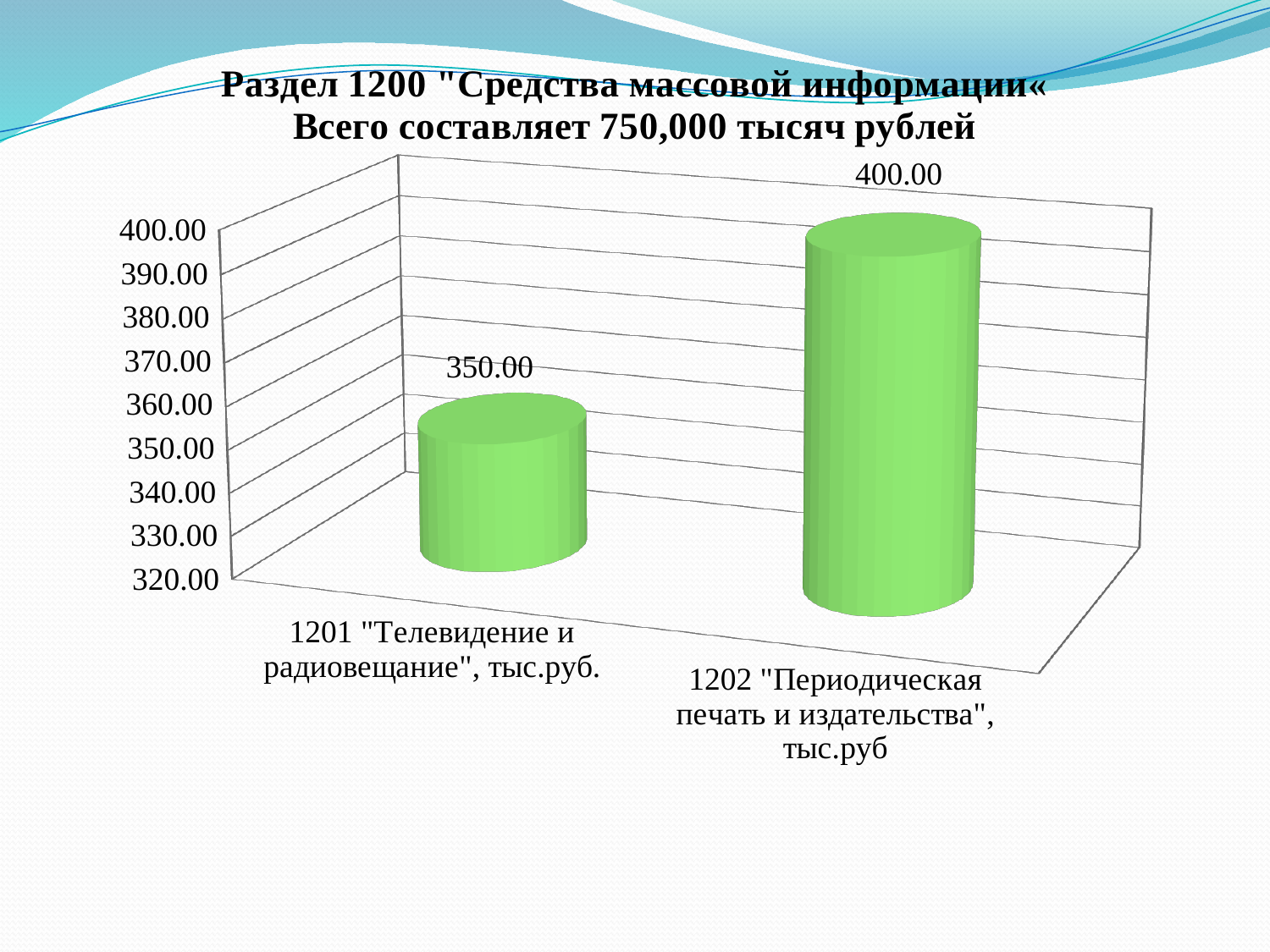
Which is larger: the value for 1201 "Телевидение и радиовещание" or for 1202 "Периодическая печать и издательства"? 1202 "Периодическая печать и издательства" Which category has the highest value? 1202 "Периодическая печать и издательства" Which category has the lowest value? 1201 "Телевидение и радиовещание" What is the value for 1201 "Телевидение и радиовещание"? 350.00 Do the values rise or fall from the first category to the second? rise What is the lowest value shown on the vertical axis? 320.00 Is the value for 1201 "Телевидение и радиовещание" greater or less than 380.00? less What is the value for 1202 "Периодическая печать и издательства"? 400.00 What kind of chart is shown on the slide? bar chart What total amount is stated in the chart title? 750,000 тысяч рублей What is the difference between the values for 1202 "Периодическая печать и издательства" and 1201 "Телевидение и радиовещание"? 50.00 How many categories are shown in the chart? 2